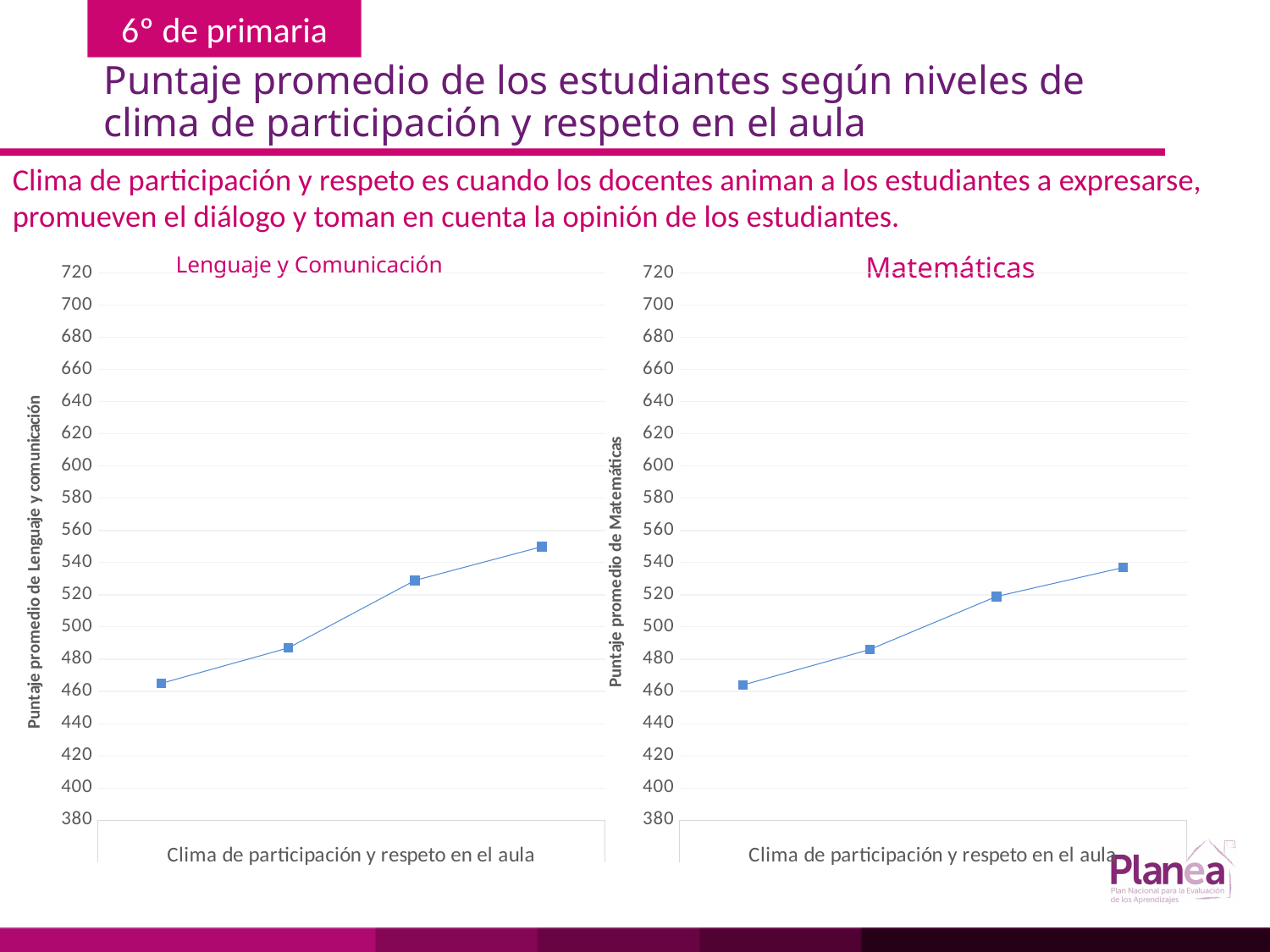
On the Matemáticas chart, is the value of the third point from the left greater or less than 500? greater How many data points are plotted on the Matemáticas chart? 4 What is the y-axis title of the Matemáticas chart? Puntaje promedio de Matemáticas On the Lenguaje y Comunicación chart, do the values rise or fall from left to right along the x axis? rise What kind of chart is the Lenguaje y Comunicación chart? line chart What kind of chart is the Matemáticas chart? line chart On the Matemáticas chart, do the values rise or fall from left to right along the x axis? rise How many data points are plotted on the Lenguaje y Comunicación chart? 4 On the Lenguaje y Comunicación chart, is the value of the rightmost point greater or less than 540? greater On the Matemáticas chart, is the value of the leftmost point greater or less than 480? less On the Matemáticas chart, which point has the highest value, the leftmost or the rightmost? rightmost